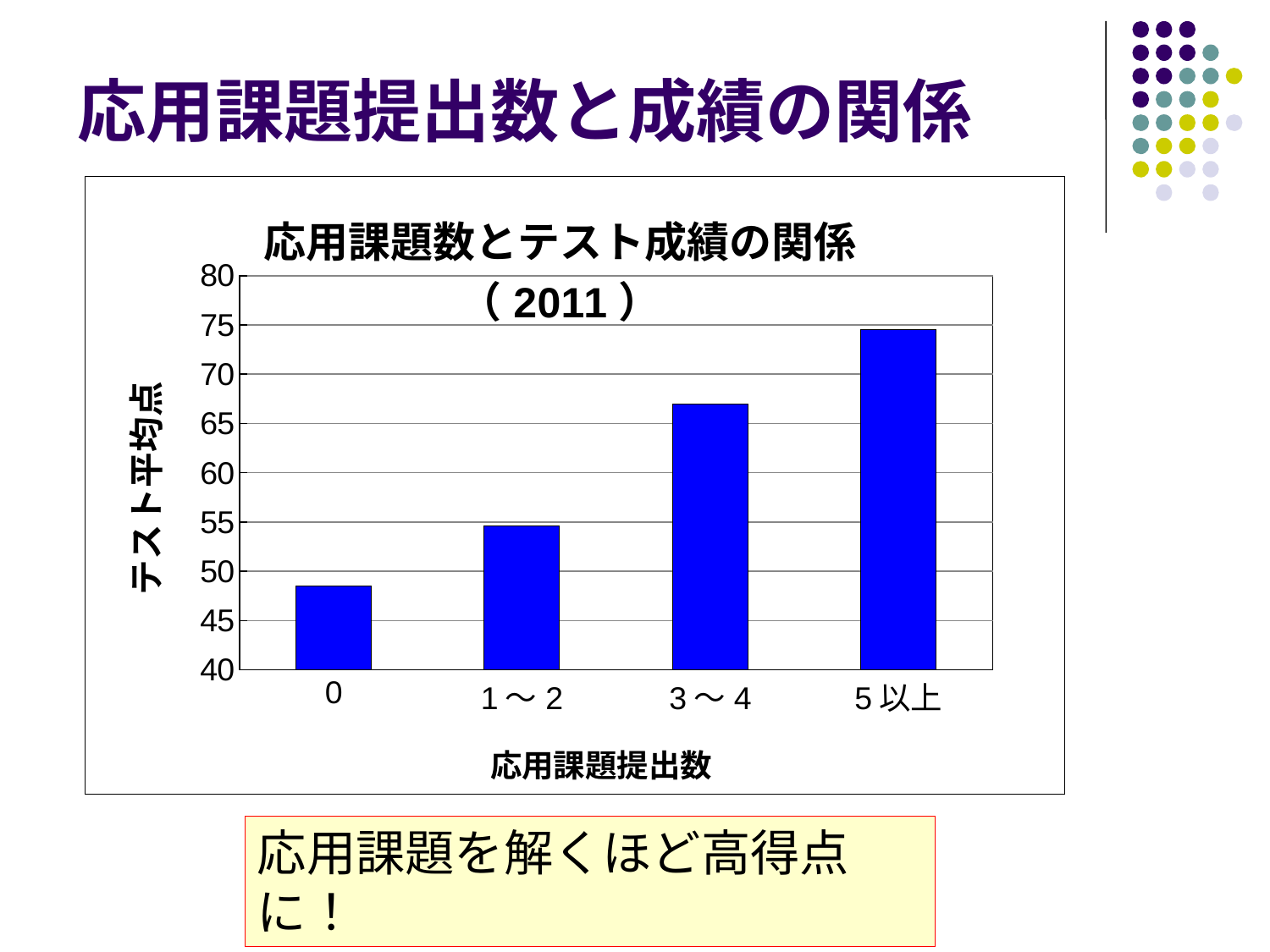
What kind of chart is shown on the slide? bar chart Which has a higher テスト平均点, 0 or 5以上? 5以上 Do the values rise or fall as 応用課題提出数 increases along the x axis? rise How many categories are shown on the x axis of the chart? 4 Is the value for 1～2 greater or less than 50? greater What is the label of the y axis of the chart? テスト平均点 Which category has the lowest テスト平均点? 0 Is the value for 5以上 greater or less than 70? greater Which category has the highest テスト平均点? 5以上 Which has a higher テスト平均点, 1～2 or 3～4? 3～4 Is the value for 0 greater or less than 50? less